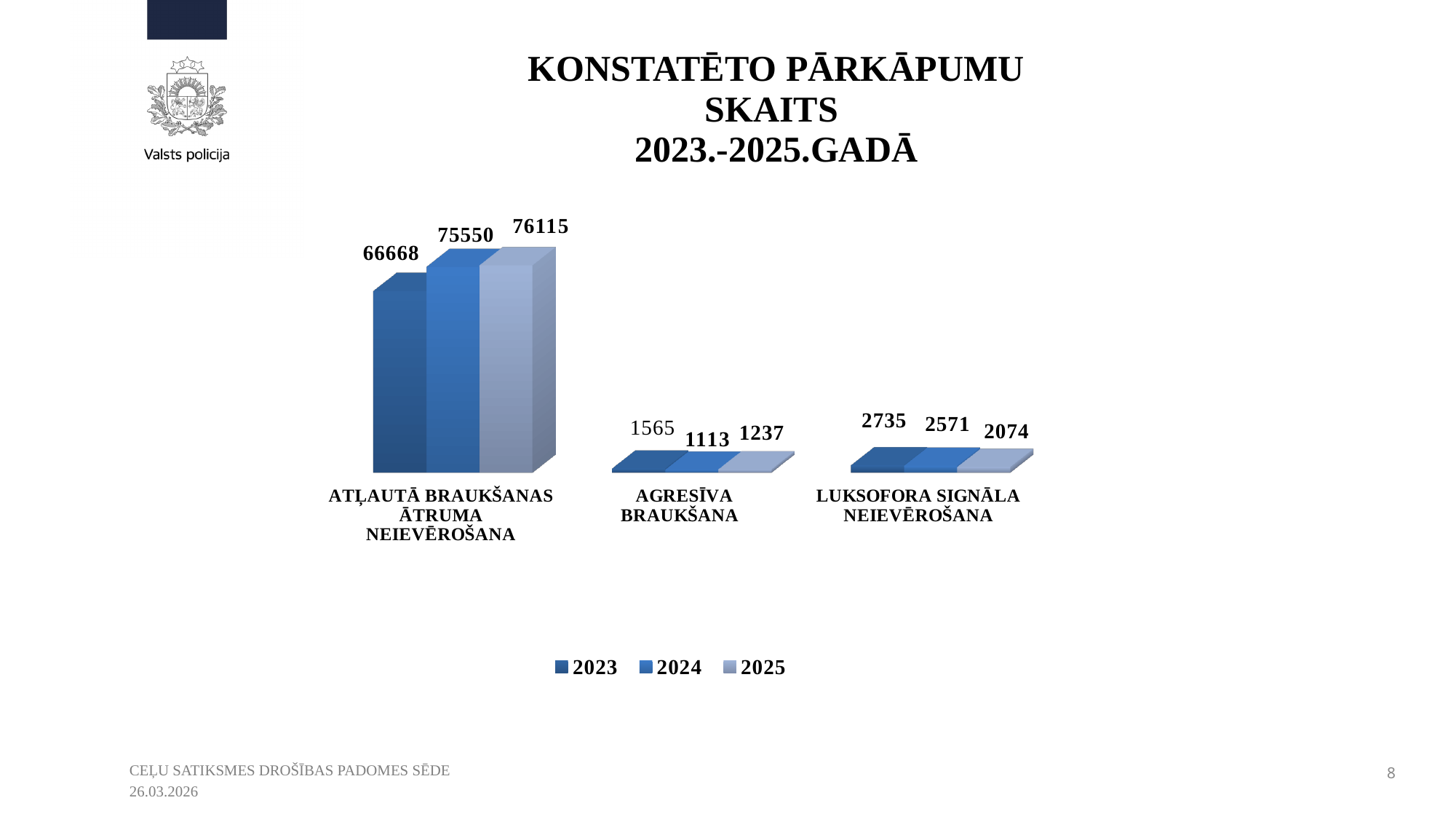
Do the values for LUKSOFORA SIGNĀLA NEIEVĒROŠANA rise or fall from 2023 to 2025? fall Which category has the highest value in 2024? ATĻAUTĀ BRAUKŠANAS ĀTRUMA NEIEVĒROŠANA What is the difference between the 2025 and 2023 values for ATĻAUTĀ BRAUKŠANAS ĀTRUMA NEIEVĒROŠANA? 9447 What kind of chart is shown on the slide? bar chart What is the value for LUKSOFORA SIGNĀLA NEIEVĒROŠANA in 2024? 2571 How many series does the legend list? 3 What is the difference between the 2023 and 2025 values for LUKSOFORA SIGNĀLA NEIEVĒROŠANA? 661 Which category has the lowest value in 2025? AGRESĪVA BRAUKŠANA What is the value for ATĻAUTĀ BRAUKŠANAS ĀTRUMA NEIEVĒROŠANA in 2025? 76115 How many categories are shown on the x axis? 3 What is the value for AGRESĪVA BRAUKŠANA in 2023? 1565 Which is larger for AGRESĪVA BRAUKŠANA: the 2024 value or the 2025 value? 2025